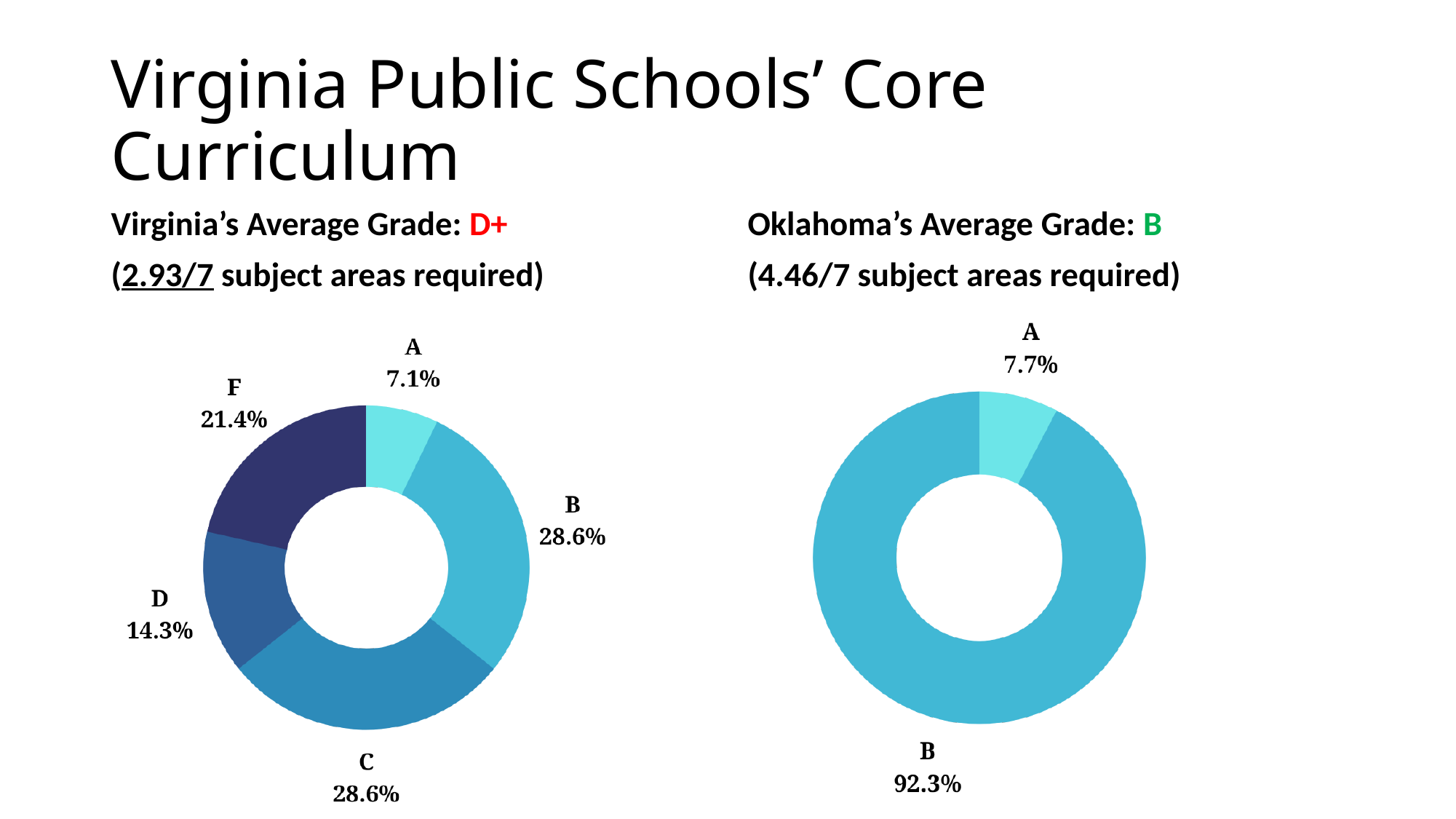
In the Oklahoma chart on the right, which grade has the largest share? B How many grade categories are shown in the Virginia chart on the left? 5 In the Oklahoma chart on the right, what percentage is shown for grade B? 92.3% What kind of chart is used for the Virginia grade distribution on the left? Doughnut (pie) chart In the Virginia chart on the left, what is the difference in percentage points between the F share and the D share? 7.1 In the Virginia chart on the left, what is the combined share of grades B and C? 57.2% How many grade categories are shown in the Oklahoma chart on the right? 2 In the Virginia chart on the left, what percentage of schools received a grade of F? 21.4% In the Virginia chart on the left, which grade has the smallest share? A In the Virginia chart on the left, which is larger, the share for F or the share for D? F In the Virginia chart on the left, what percentage is shown for grade A? 7.1% In the Oklahoma chart on the right, what percentage is shown for grade A? 7.7%